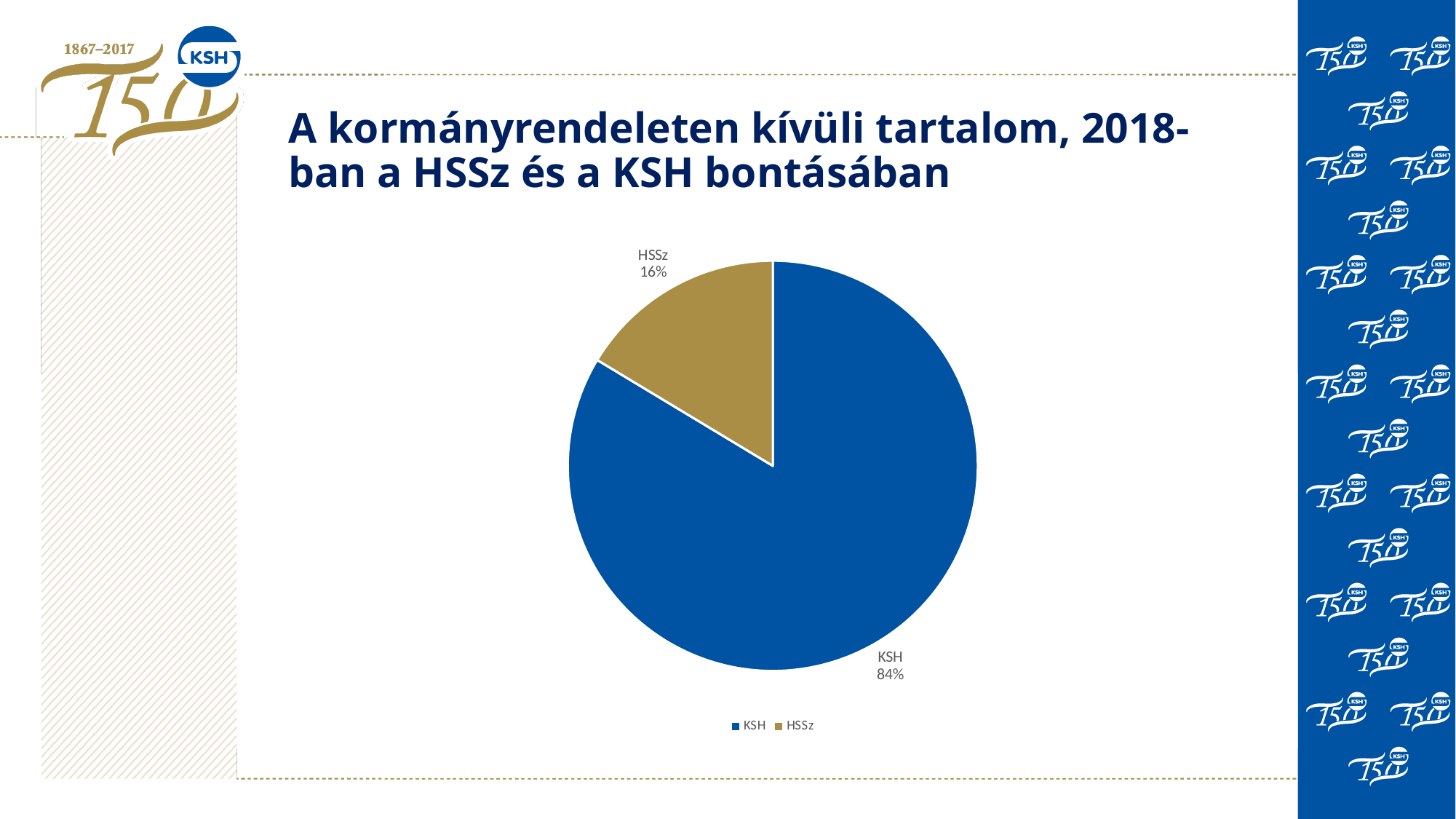
Which is larger, the KSH share or the HSSz share? KSH Which slice of the pie is the largest? KSH What colour is the KSH slice of the pie? Blue Which slice of the pie is the smallest? HSSz What share of the pie does KSH account for? 84% What kind of chart is shown on the slide? Pie chart What is the difference in percentage points between the KSH and HSSz shares? 68 percentage points How many entries does the legend list? 2 What share of the pie does HSSz account for? 16% What colour is the HSSz slice of the pie? Gold How many slices does the pie chart have? 2